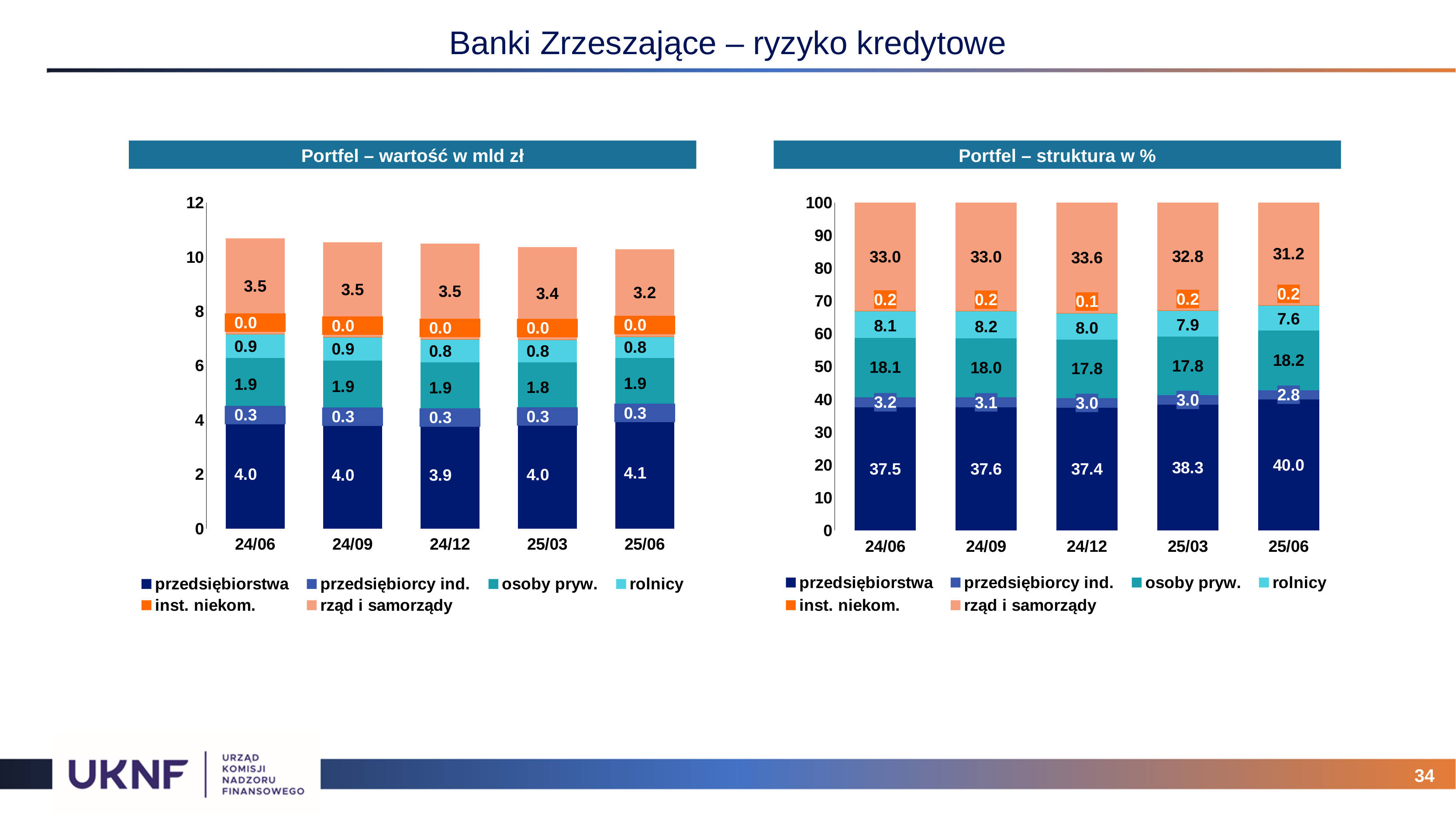
How many periods are shown on the x axis of the chart titled "Portfel – struktura w %"? 5 In the chart titled "Portfel – struktura w %", at which period is the rząd i samorządy share lowest? 25/06 In the chart titled "Portfel – struktura w %", what is the value for rząd i samorządy at 24/12? 33.6 In the chart titled "Portfel – wartość w mld zł", is the total height of the 24/06 bar greater or less than 10? greater In the chart titled "Portfel – struktura w %", at which period is the przedsiębiorstwa share highest? 25/06 In the chart titled "Portfel – struktura w %", what is the difference between the przedsiębiorstwa share at 25/06 and at 24/06? 2.5 In the chart titled "Portfel – wartość w mld zł", what is the difference between the rząd i samorządy value at 24/06 and at 25/06? 0.3 In the chart titled "Portfel – wartość w mld zł", what is the value for przedsiębiorstwa at 25/06? 4.1 In the chart titled "Portfel – wartość w mld zł", which is larger at 25/03: osoby pryw. or rolnicy? osoby pryw. In the chart titled "Portfel – struktura w %", what is the value for osoby pryw. at 25/06? 18.2 How many series does the legend of the chart titled "Portfel – wartość w mld zł" list? 6 In the chart titled "Portfel – wartość w mld zł", does the rząd i samorządy value rise or fall from 24/06 to 25/06? fall